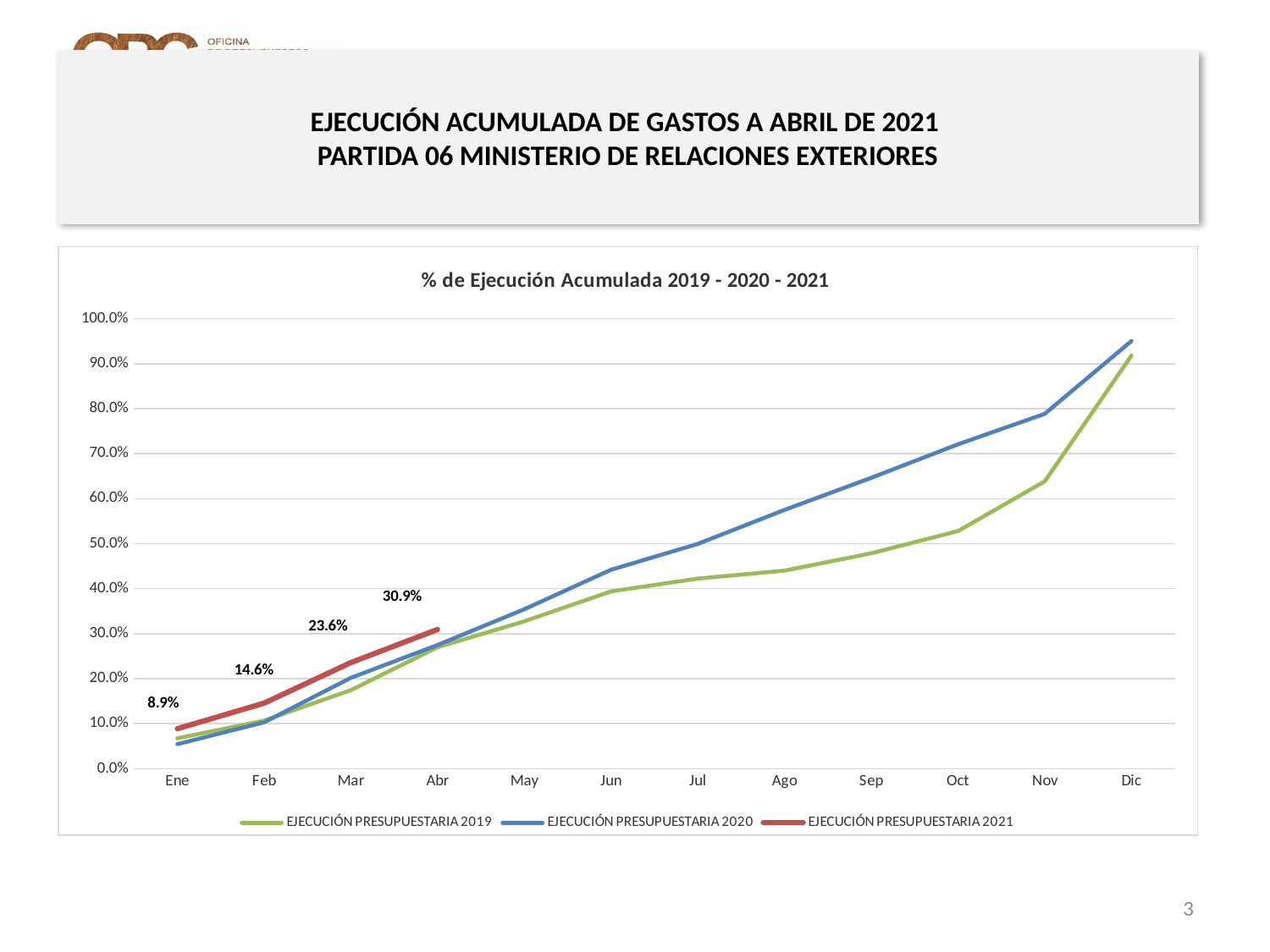
What is the value of EJECUCIÓN PRESUPUESTARIA 2021 in Ene? 8.9% What is the title of the chart? % de Ejecución Acumulada 2019 - 2020 - 2021 How many months are shown on the x axis? 12 In Nov, which series is higher: EJECUCIÓN PRESUPUESTARIA 2019 or EJECUCIÓN PRESUPUESTARIA 2020? EJECUCIÓN PRESUPUESTARIA 2020 What is the difference between the Feb and Ene values of EJECUCIÓN PRESUPUESTARIA 2021? 5.7% Is the value for EJECUCIÓN PRESUPUESTARIA 2020 in Dic greater or less than 90.0%? greater Does EJECUCIÓN PRESUPUESTARIA 2021 rise or fall from Ene to Abr? Rises What is the value of EJECUCIÓN PRESUPUESTARIA 2021 in Mar? 23.6% What is the value of EJECUCIÓN PRESUPUESTARIA 2021 in Abr? 30.9% What kind of chart is shown on the slide? Line chart How many series does the legend list? 3 By how much did EJECUCIÓN PRESUPUESTARIA 2021 increase from Mar to Abr? 7.3%